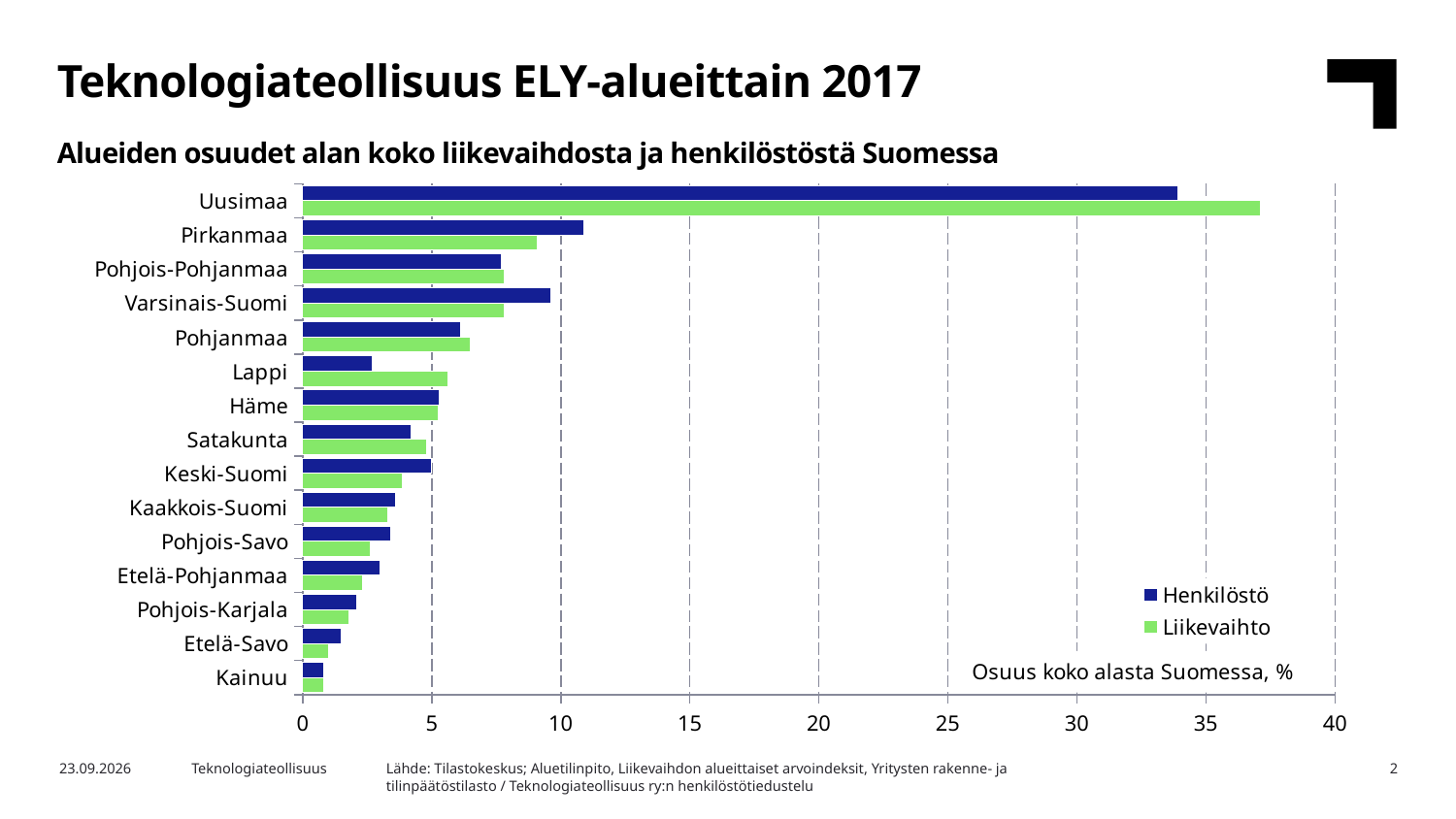
Is the Henkilöstö value for Pirkanmaa greater or less than 10? greater How many series does the legend list? 2 Which region has the lowest Liikevaihto share? Kainuu For Varsinais-Suomi, which is larger: Henkilöstö or Liikevaihto? Henkilöstö For Lappi, which is larger: Henkilöstö or Liikevaihto? Liikevaihto Is the Liikevaihto value for Uusimaa greater or less than 35? greater Is the Henkilöstö value for Uusimaa greater or less than 30? greater Which colour represents the Liikevaihto series? Green How many regions (categories) are shown on the chart? 15 What kind of chart is shown on the slide? Bar chart Which region has the highest Henkilöstö share? Uusimaa